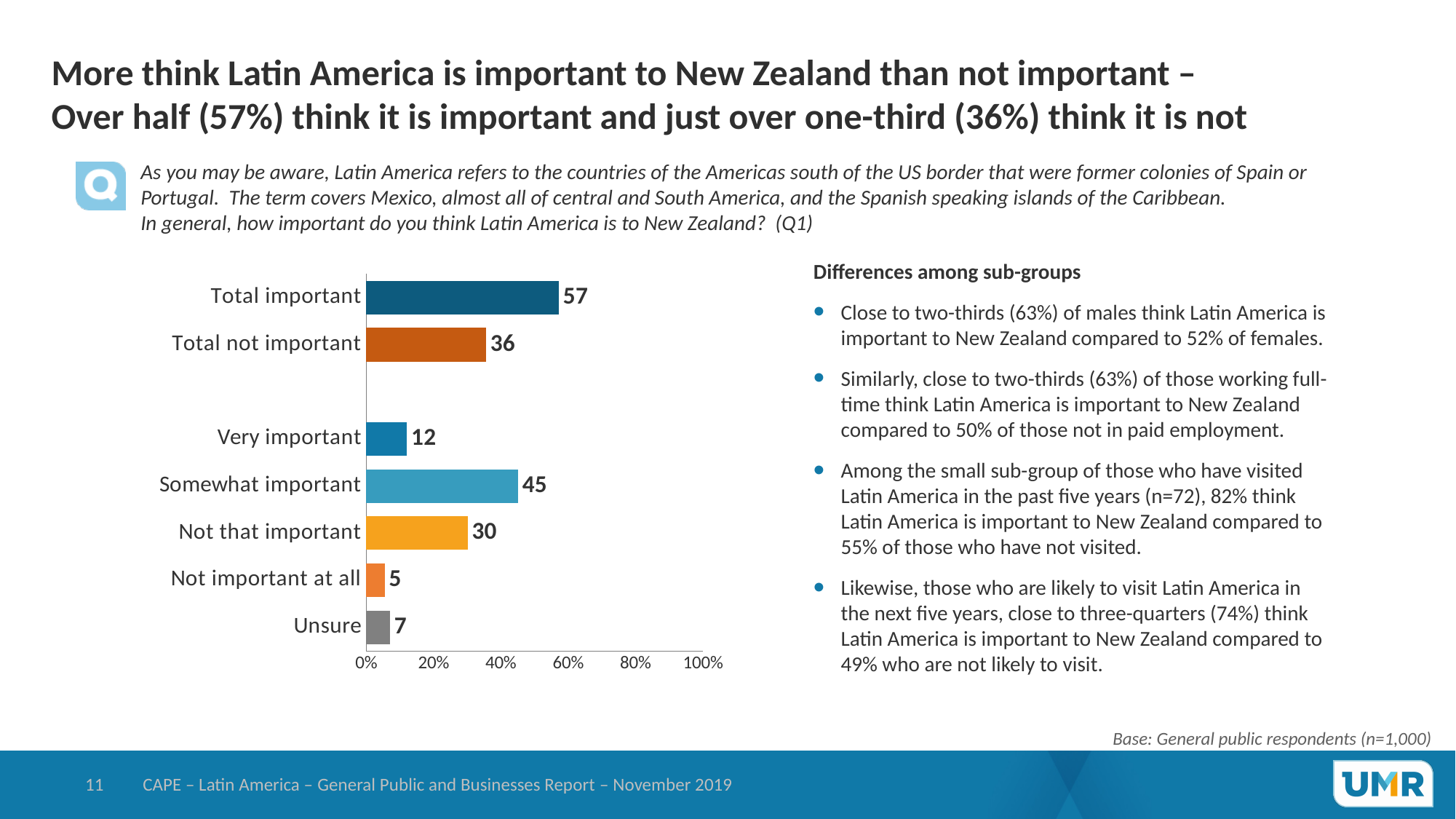
What is the value for Not important at all? 5 What is the value for Somewhat important? 45 Which category has the lowest value? Not important at all What is the value for Total not important? 36 What is the difference between Total important and Total not important? 21 What is the value for Unsure? 7 How many categories are shown in the chart? 7 Which category has the highest value? Total important Is the value for Somewhat important greater or less than 40%? greater Which is larger, Very important or Not that important? Not that important What kind of chart is shown on the slide? Bar chart What is the value for Total important? 57